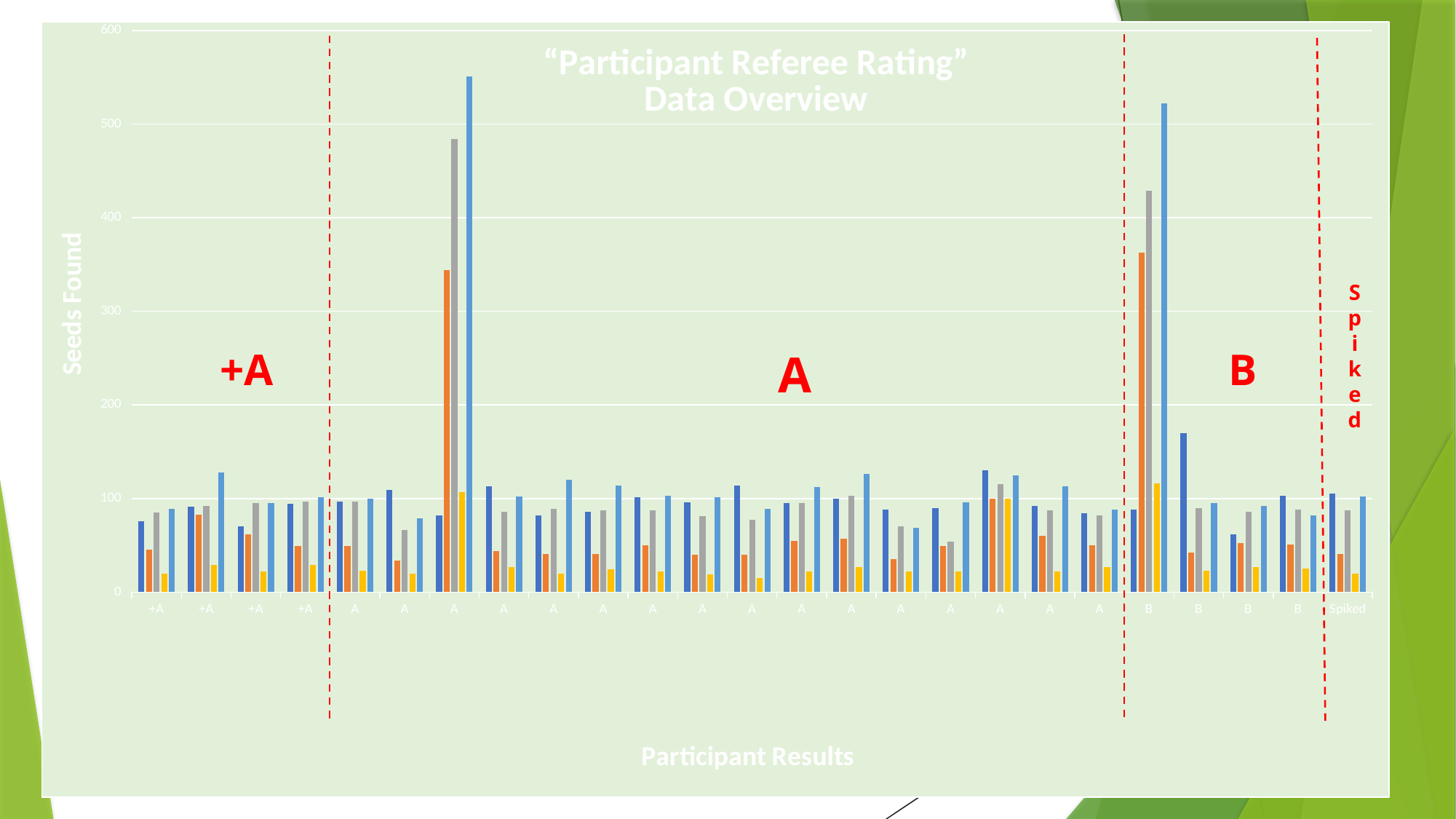
How many category groups labelled "+A" are on the x axis? 4 How many category groups labelled "B" are on the x axis? 4 What kind of chart is shown on the slide? bar chart Is the tallest bar in the +A section greater or less than 200? less Is the tallest bar in the B section greater or less than 500? greater Is the tallest bar in the Spiked section greater or less than 200? less Which section of the chart (+A, A, B or Spiked) contains the tallest bar? A How many category groups labelled "Spiked" are on the x axis? 1 What is the label on the vertical axis of the chart? Seeds Found What is the title of the chart? "Participant Referee Rating" Data Overview